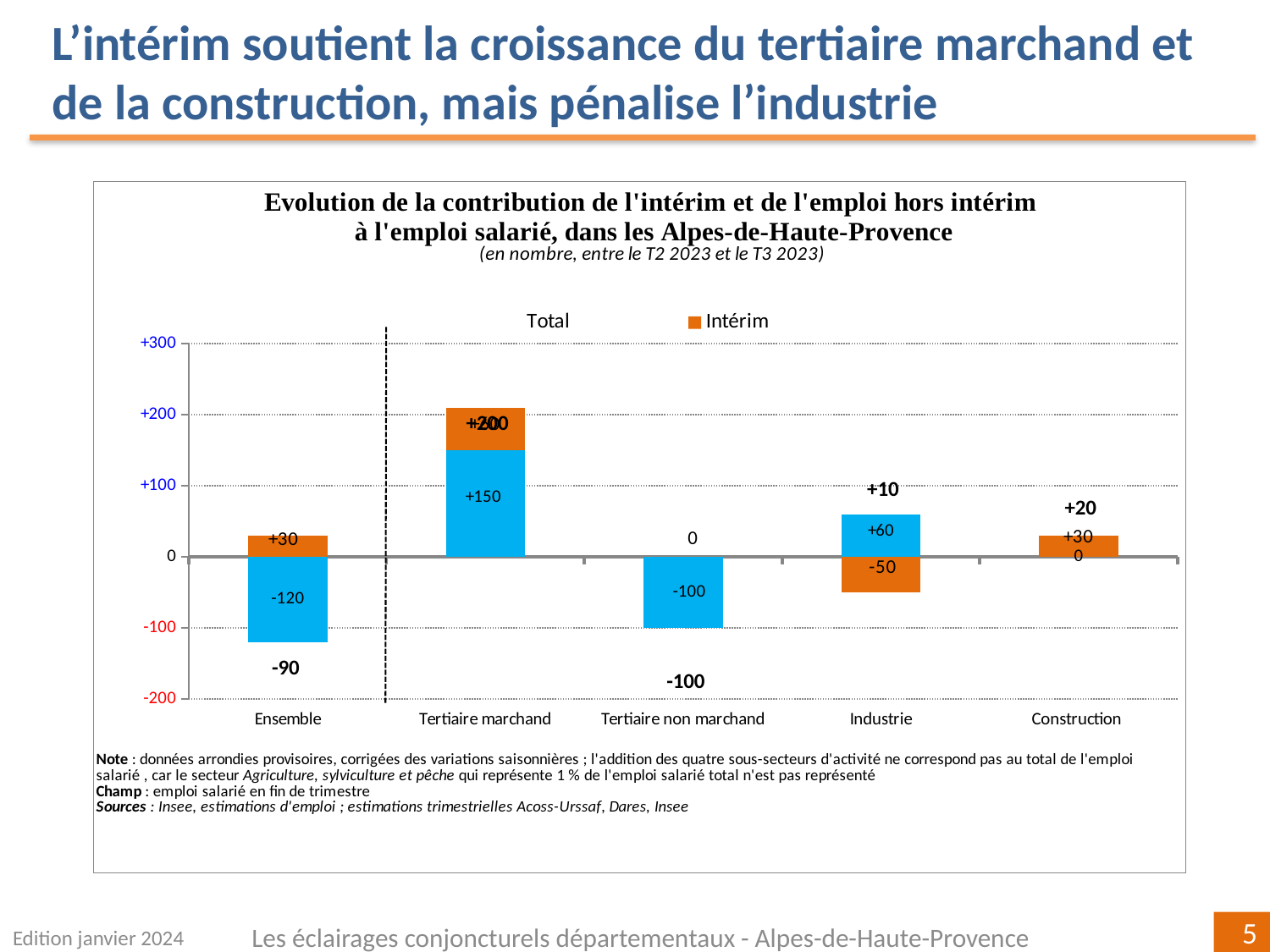
What is the Total value for Tertiaire non marchand? -100 What kind of chart is shown on the slide? bar chart Which category has the highest Total value? Tertiaire marchand What is the Total value for Construction? +20 What colour represents the Intérim series in the legend? orange What is the Intérim value for Tertiaire non marchand? 0 What is the Intérim value for Ensemble? +30 Which is larger, the Intérim value for Ensemble or the Intérim value for Industrie? Ensemble What is the Intérim value for Industrie? -50 What is the Total value for Industrie? +10 How many categories are shown along the x axis of the chart? 5 What is the Total value for Ensemble? -90